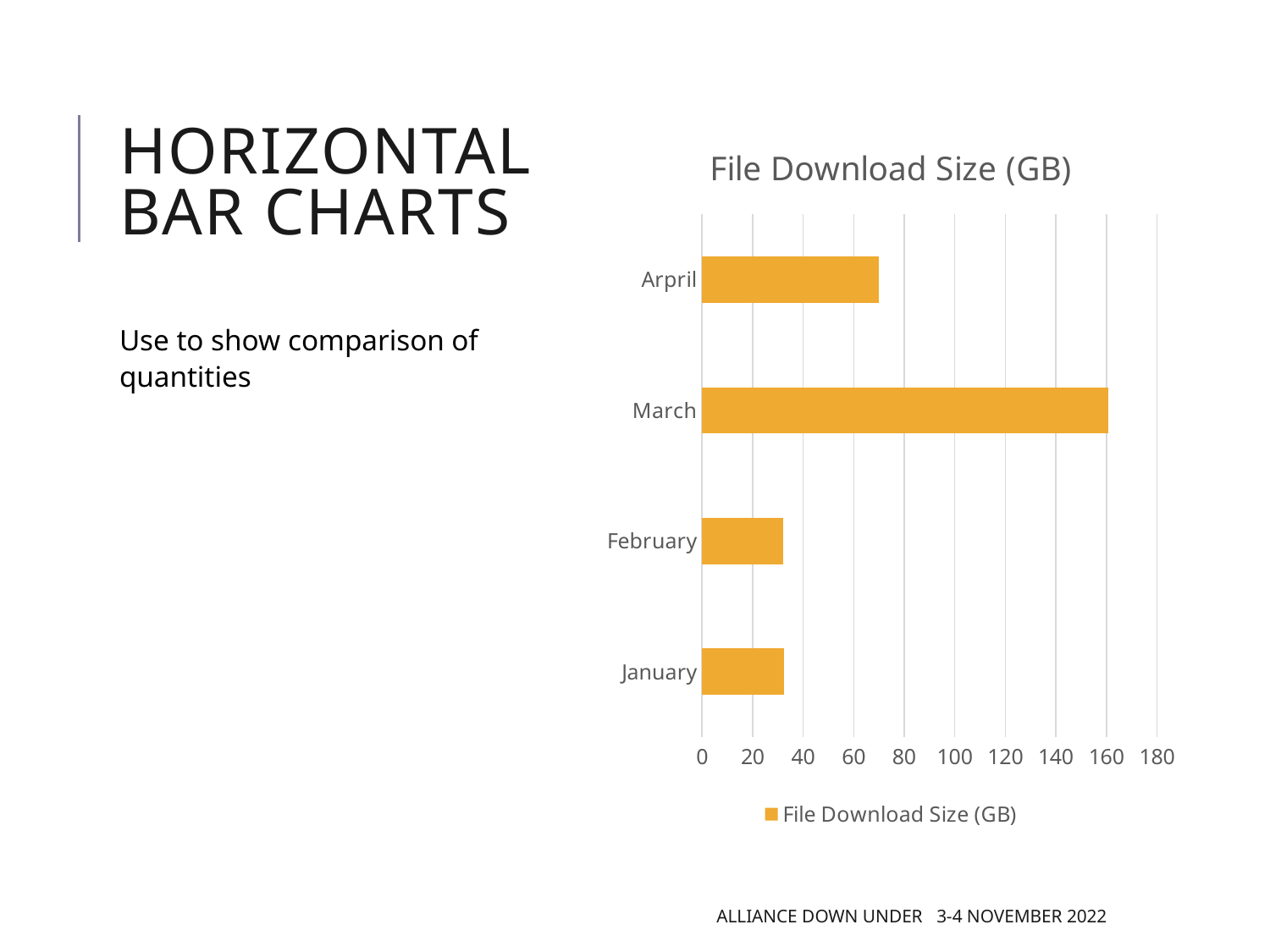
What is the title of the chart? File Download Size (GB) Is the value for Arpril greater or less than 80? less Which is larger, the value for March or the value for Arpril? March Is the value for March greater or less than 140? greater Is the value for Arpril greater or less than 60? greater How many series does the legend list? 1 Which month has the highest file download size? March What kind of chart is shown on the slide? Bar chart Which is larger, the value for Arpril or the value for February? Arpril How many categories (months) are plotted in the chart? 4